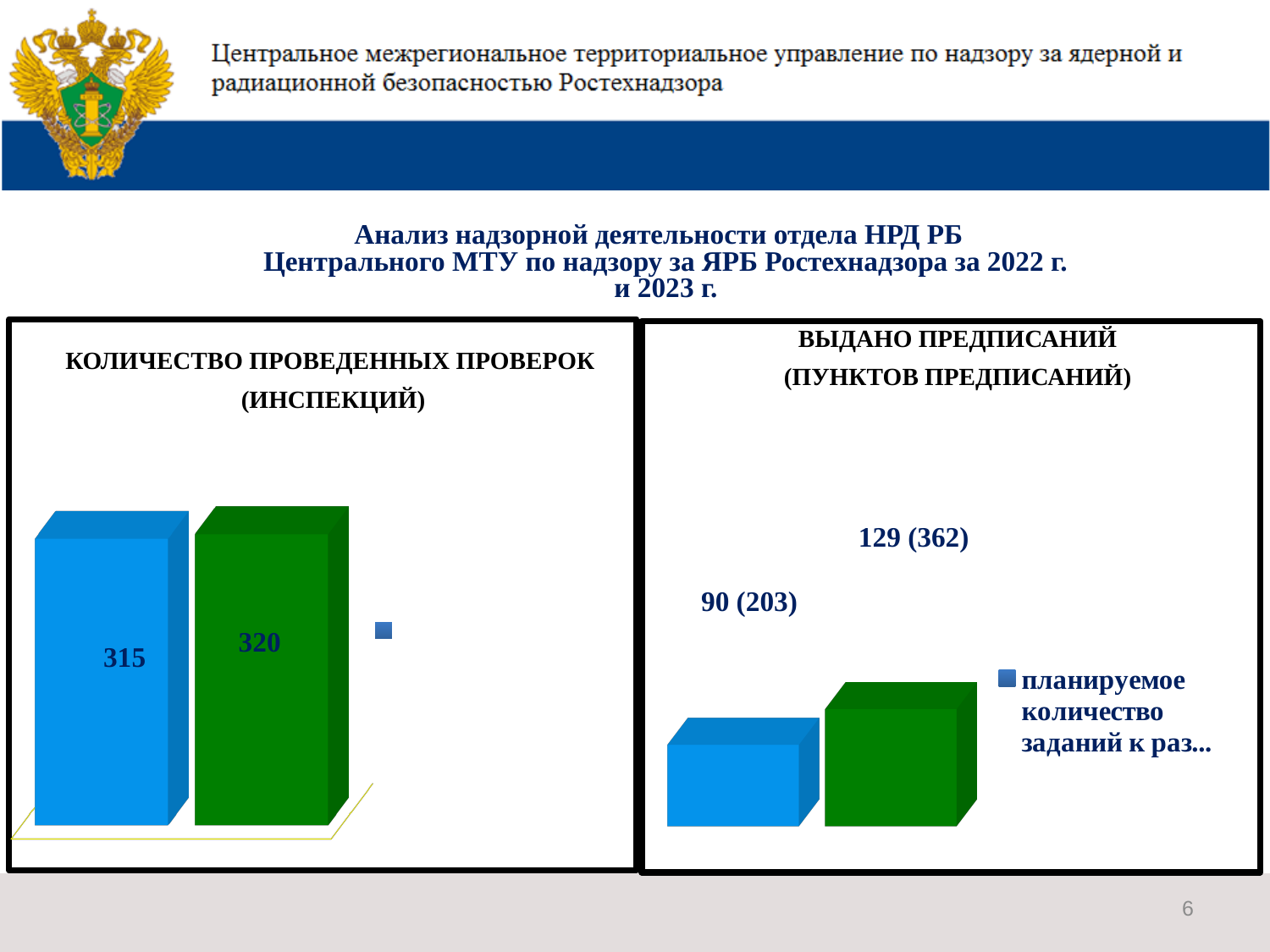
In the left chart "КОЛИЧЕСТВО ПРОВЕДЕННЫХ ПРОВЕРОК (ИНСПЕКЦИЙ)", what is the difference between the green bar and the blue bar? 5 In the right chart "ВЫДАНО ПРЕДПИСАНИЙ (ПУНКТОВ ПРЕДПИСАНИЙ)", what is the difference between the main values of the green bar (129) and the blue bar (90)? 39 In the right chart "ВЫДАНО ПРЕДПИСАНИЙ (ПУНКТОВ ПРЕДПИСАНИЙ)", what is the difference between the bracketed values 362 and 203? 159 In the right chart "ВЫДАНО ПРЕДПИСАНИЙ (ПУНКТОВ ПРЕДПИСАНИЙ)", what label is shown for the green bar? 129 (362) In the right chart "ВЫДАНО ПРЕДПИСАНИЙ (ПУНКТОВ ПРЕДПИСАНИЙ)", what label is shown for the blue bar? 90 (203) In the left chart "КОЛИЧЕСТВО ПРОВЕДЕННЫХ ПРОВЕРОК (ИНСПЕКЦИЙ)", what value is labelled on the green bar? 320 What is the title of the chart on the right side of the slide? ВЫДАНО ПРЕДПИСАНИЙ (ПУНКТОВ ПРЕДПИСАНИЙ) In the right chart "ВЫДАНО ПРЕДПИСАНИЙ (ПУНКТОВ ПРЕДПИСАНИЙ)", which bar is taller, the blue one or the green one? The green bar In the right chart "ВЫДАНО ПРЕДПИСАНИЙ (ПУНКТОВ ПРЕДПИСАНИЙ)", how many bars are plotted? 2 In the left chart "КОЛИЧЕСТВО ПРОВЕДЕННЫХ ПРОВЕРОК (ИНСПЕКЦИЙ)", what value is labelled on the blue bar? 315 In the left chart "КОЛИЧЕСТВО ПРОВЕДЕННЫХ ПРОВЕРОК (ИНСПЕКЦИЙ)", how many bars are plotted? 2 What type of chart is shown in the left panel titled "КОЛИЧЕСТВО ПРОВЕДЕННЫХ ПРОВЕРОК (ИНСПЕКЦИЙ)"? Bar chart